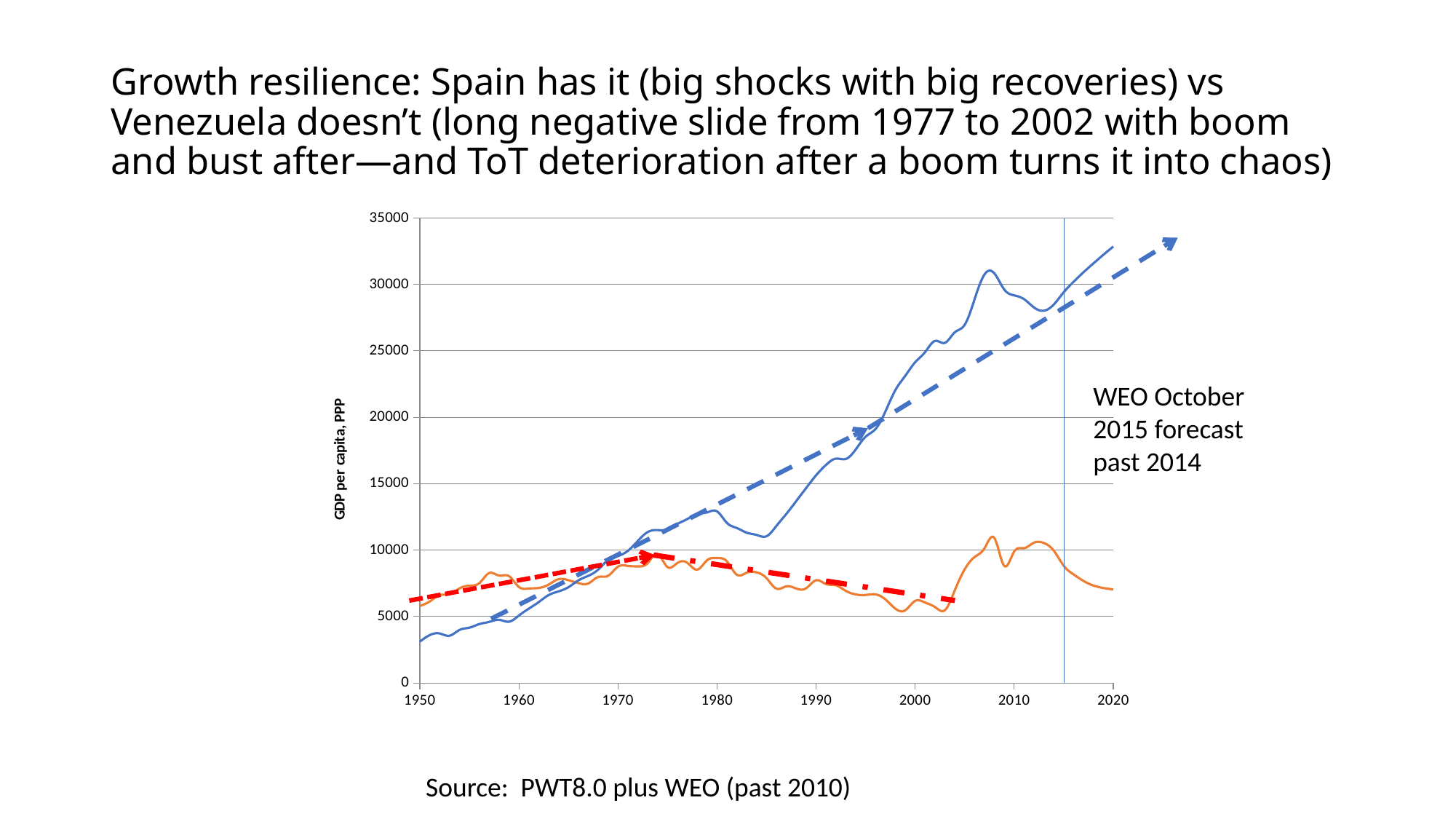
What kind of chart is shown on the slide? Line chart How many solid data lines are plotted on the chart? 2 Is the value of the blue line in 2020 greater or less than 30000? greater Does the blue line generally rise or fall from 1950 to 2020? Rise Is the value of the blue line in 1985 greater or less than 15000? less Is the value of the orange line in 2020 greater or less than 10000? less In 1950, which line has the higher value, the blue line or the orange line? The orange line What is the highest value shown on the vertical axis of the chart? 35000 What is the label on the vertical axis of the chart? GDP per capita, PPP In 2020, which line has the higher value, the blue line or the orange line? The blue line